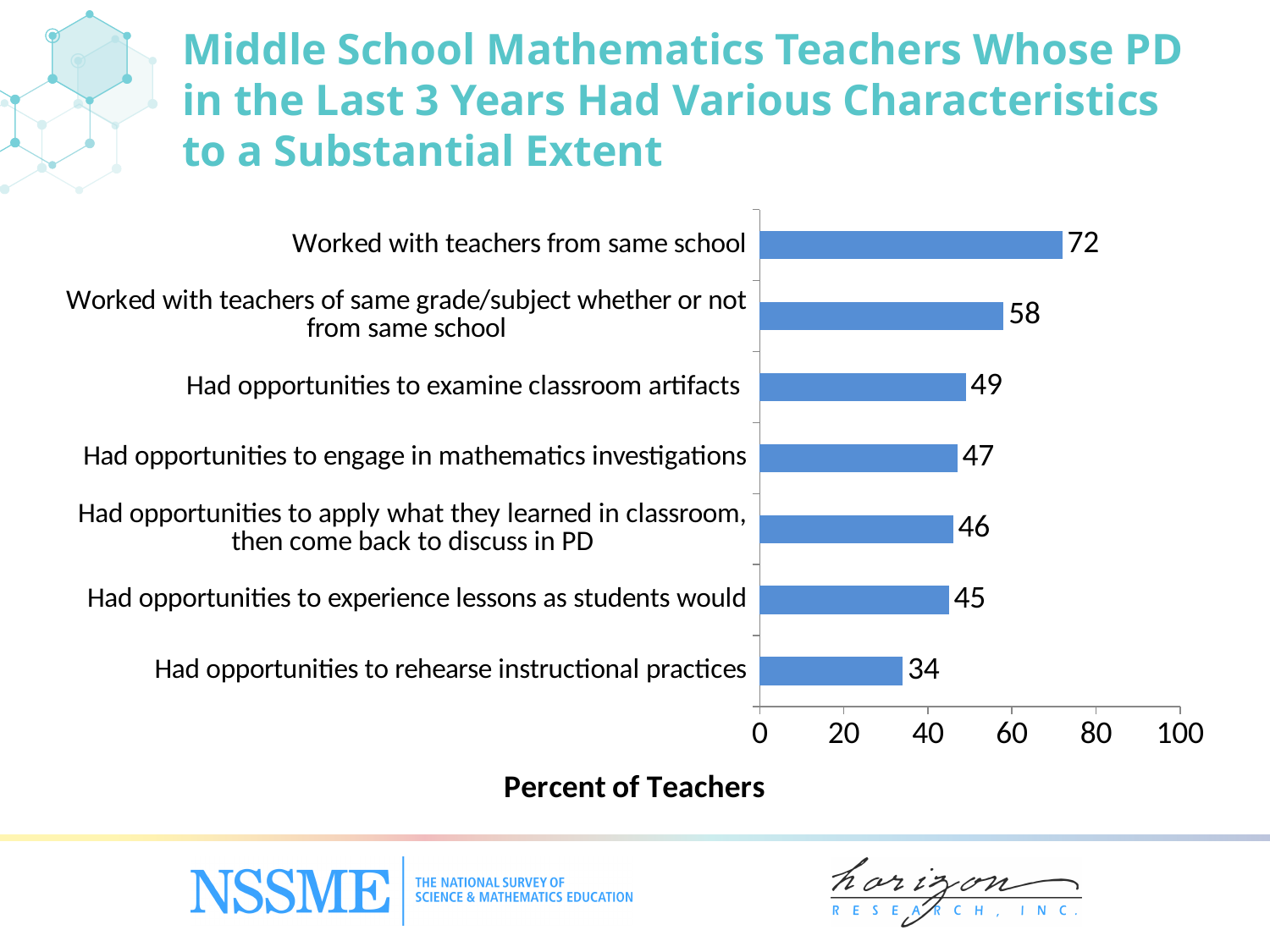
What is the difference between 'Worked with teachers from same school' and 'Worked with teachers of same grade/subject whether or not from same school'? 14 Which characteristic has the highest percent of teachers? Worked with teachers from same school How many characteristics are shown in the chart? 7 What is the value for 'Had opportunities to examine classroom artifacts'? 49 Is the value for 'Had opportunities to engage in mathematics investigations' greater or less than 40? greater What percent of teachers worked with teachers from the same school? 72 Which is larger: the value for 'Had opportunities to examine classroom artifacts' or 'Had opportunities to experience lessons as students would'? Had opportunities to examine classroom artifacts What is the difference between the values for 'Worked with teachers from same school' and 'Had opportunities to rehearse instructional practices'? 38 What is the label of the horizontal axis? Percent of Teachers What is the value for 'Had opportunities to rehearse instructional practices'? 34 What kind of chart is shown on the slide? bar chart Which characteristic has the lowest percent of teachers? Had opportunities to rehearse instructional practices